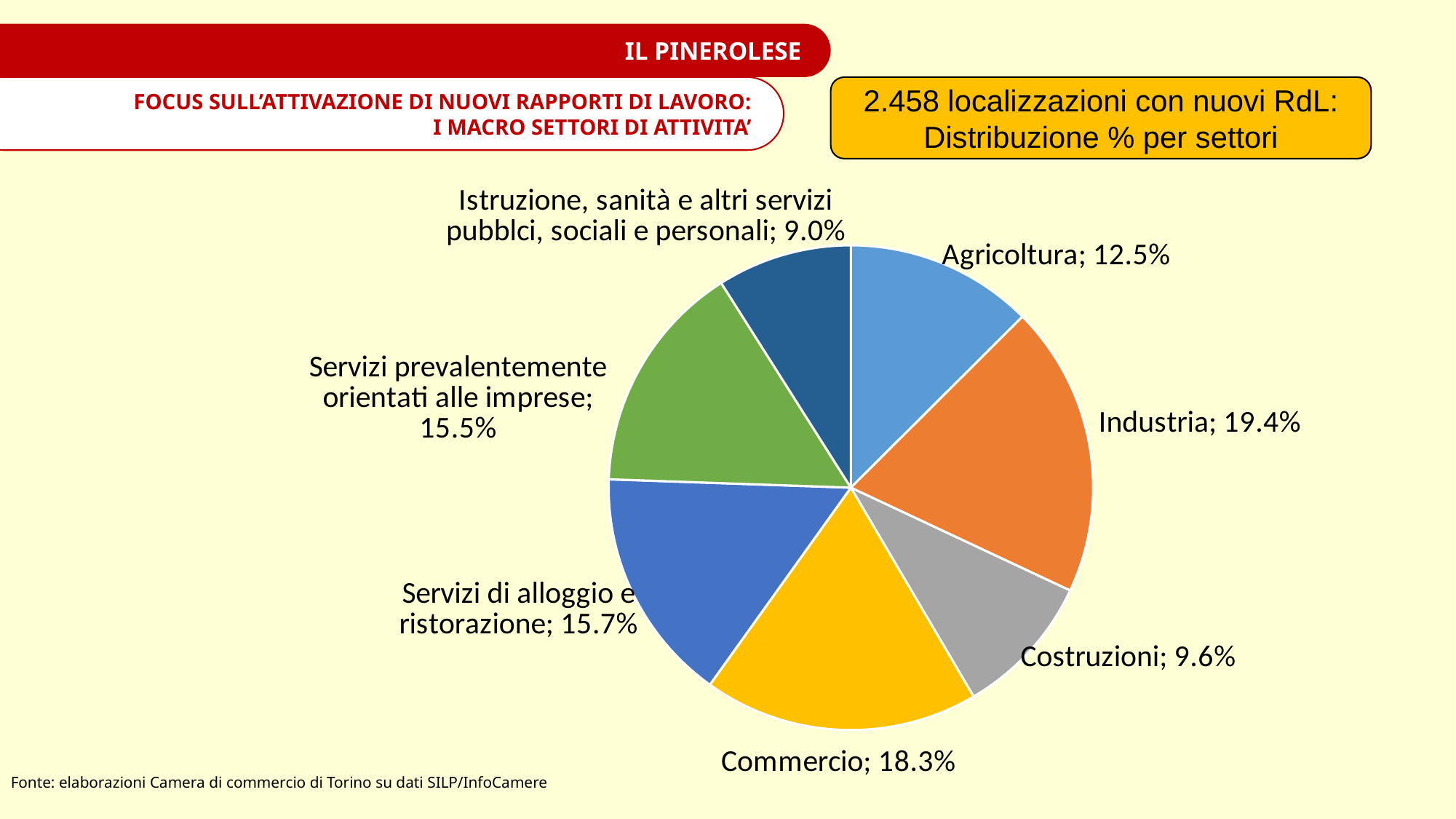
How many sectors (slices) does the pie chart show? 7 What is the percentage share for Costruzioni? 9.6% What is the difference in percentage points between Industria and Commercio? 1.1 What is the percentage share for Industria? 19.4% Which sector has the smallest share of the pie? Istruzione, sanità e altri servizi pubblci, sociali e personali Which sector has the largest share of the pie? Industria Which has a larger share, Agricoltura or Costruzioni? Agricoltura What is the percentage share for Agricoltura? 12.5% What is the combined share of Commercio and Costruzioni? 27.9% What is the percentage share for Servizi di alloggio e ristorazione? 15.7% What type of chart is shown on the slide? pie chart According to the title box, how many localizzazioni con nuovi RdL does the chart cover? 2.458